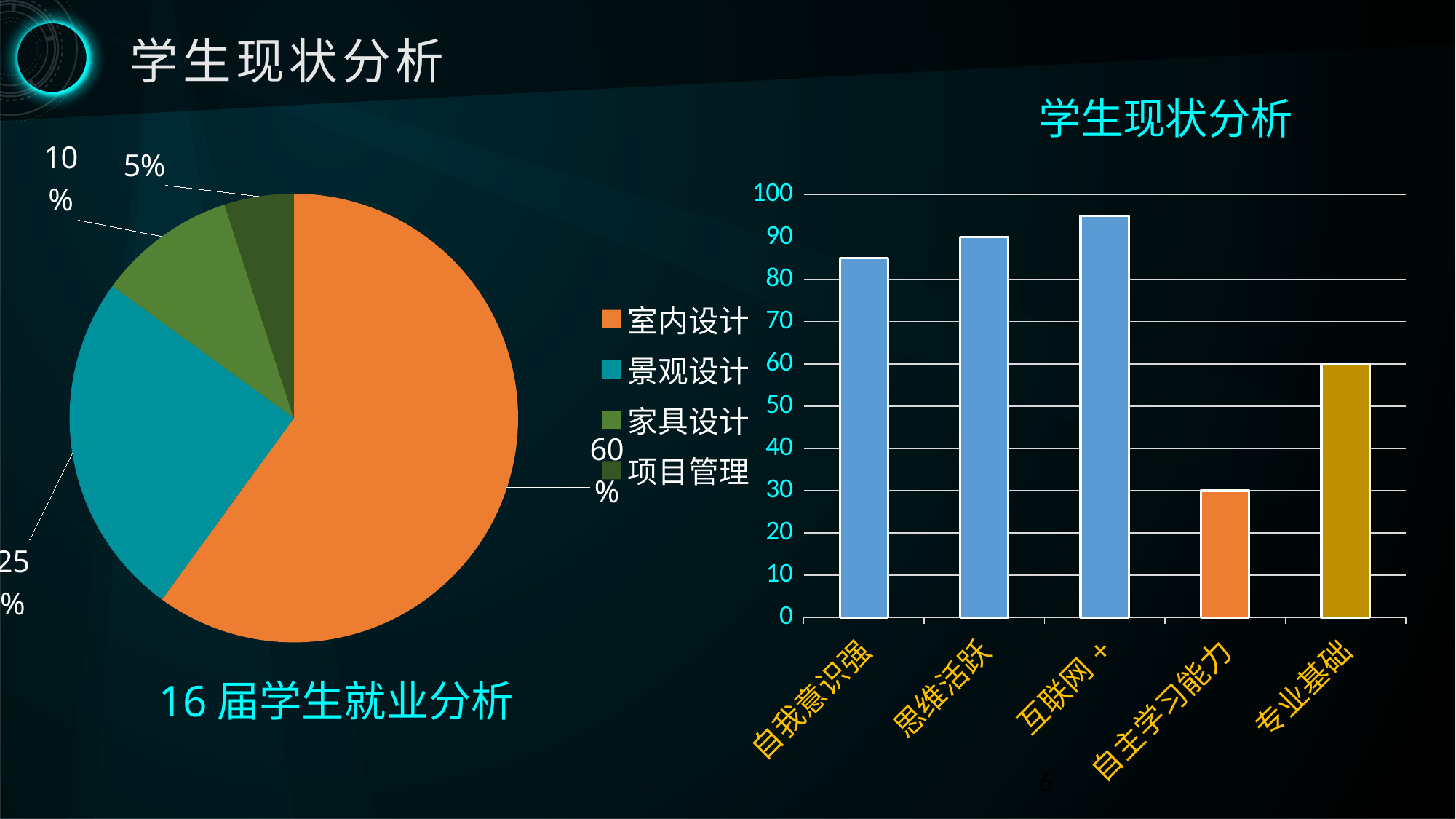
On the pie chart titled 16 届学生就业分析, how many categories does the legend list? 4 On the bar chart titled 学生现状分析, which category has the lowest bar? 自主学习能力 On the pie chart titled 16 届学生就业分析, what share does 景观设计 have? 25% On the pie chart titled 16 届学生就业分析, what is the difference between the shares of 室内设计 and 景观设计? 35% On the pie chart titled 16 届学生就业分析, which category has the smallest slice? 项目管理 On the bar chart titled 学生现状分析, what is the value for 自主学习能力? 30 What kind of chart is the chart titled 学生现状分析 on the right of the slide? bar chart On the bar chart titled 学生现状分析, is the value for 互联网＋ greater or less than 90? greater On the pie chart titled 16 届学生就业分析, which category has the largest slice? 室内设计 On the bar chart titled 学生现状分析, what is the value for 思维活跃? 90 On the pie chart titled 16 届学生就业分析, what share does 项目管理 have? 5% On the pie chart titled 16 届学生就业分析, what share does 室内设计 have? 60%